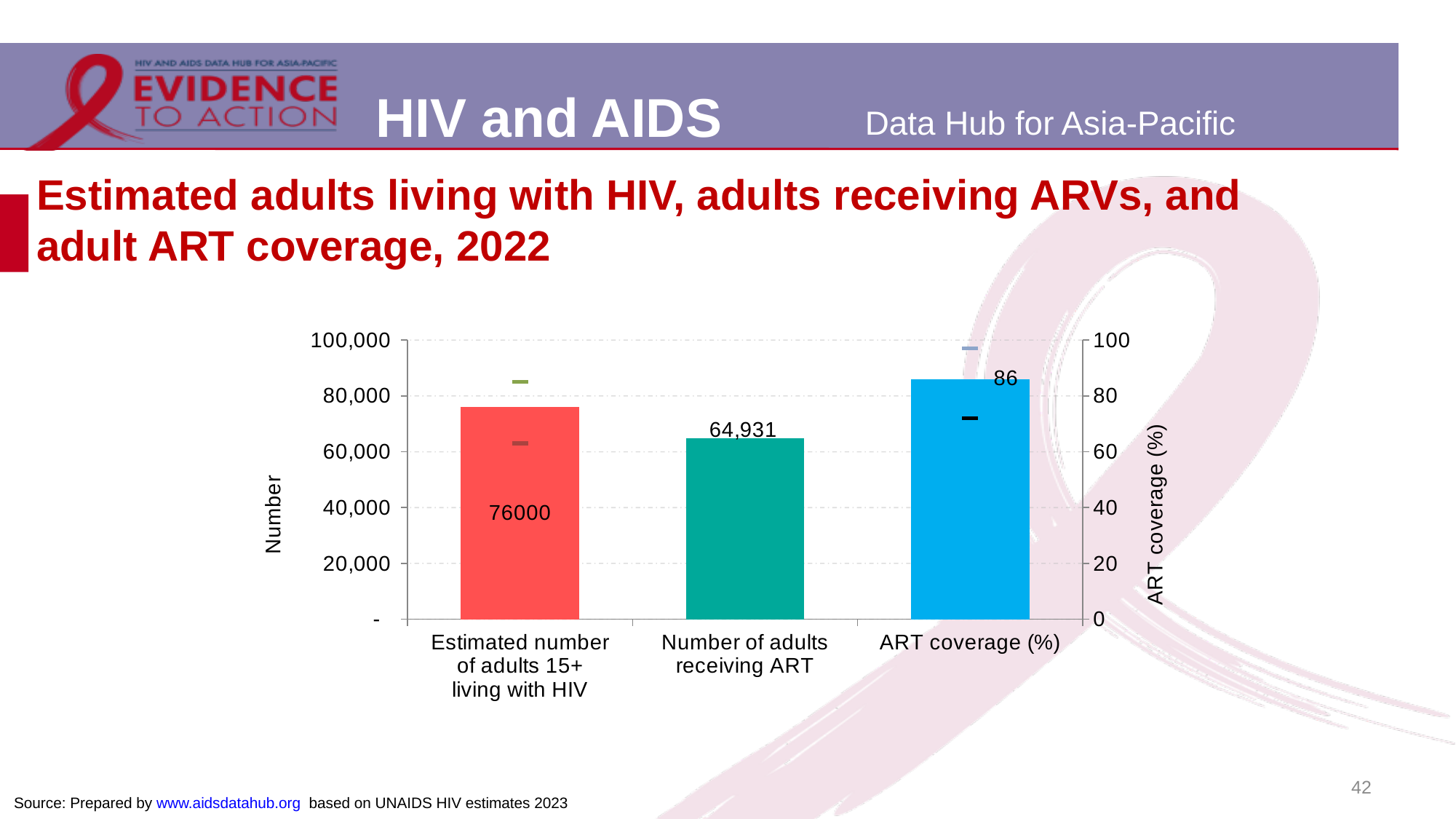
Is the ART coverage (%) value greater or less than 80 on the right-hand axis? greater What kind of chart is shown on the slide? Bar chart What is the maximum value shown on the right-hand axis? 100 What is the label of the right vertical axis? ART coverage (%) What is the ART coverage (%) value shown on the chart? 86 Is the estimated number of adults 15+ living with HIV greater or less than 80,000? less What is the label of the left vertical axis? Number How many bars are plotted on the chart? 3 What is the value shown for the number of adults receiving ART? 64,931 What is the difference between the estimated number of adults 15+ living with HIV and the number of adults receiving ART? 11,069 Which is larger: the estimated number of adults 15+ living with HIV or the number of adults receiving ART? Estimated number of adults 15+ living with HIV What is the value shown for the estimated number of adults 15+ living with HIV? 76000